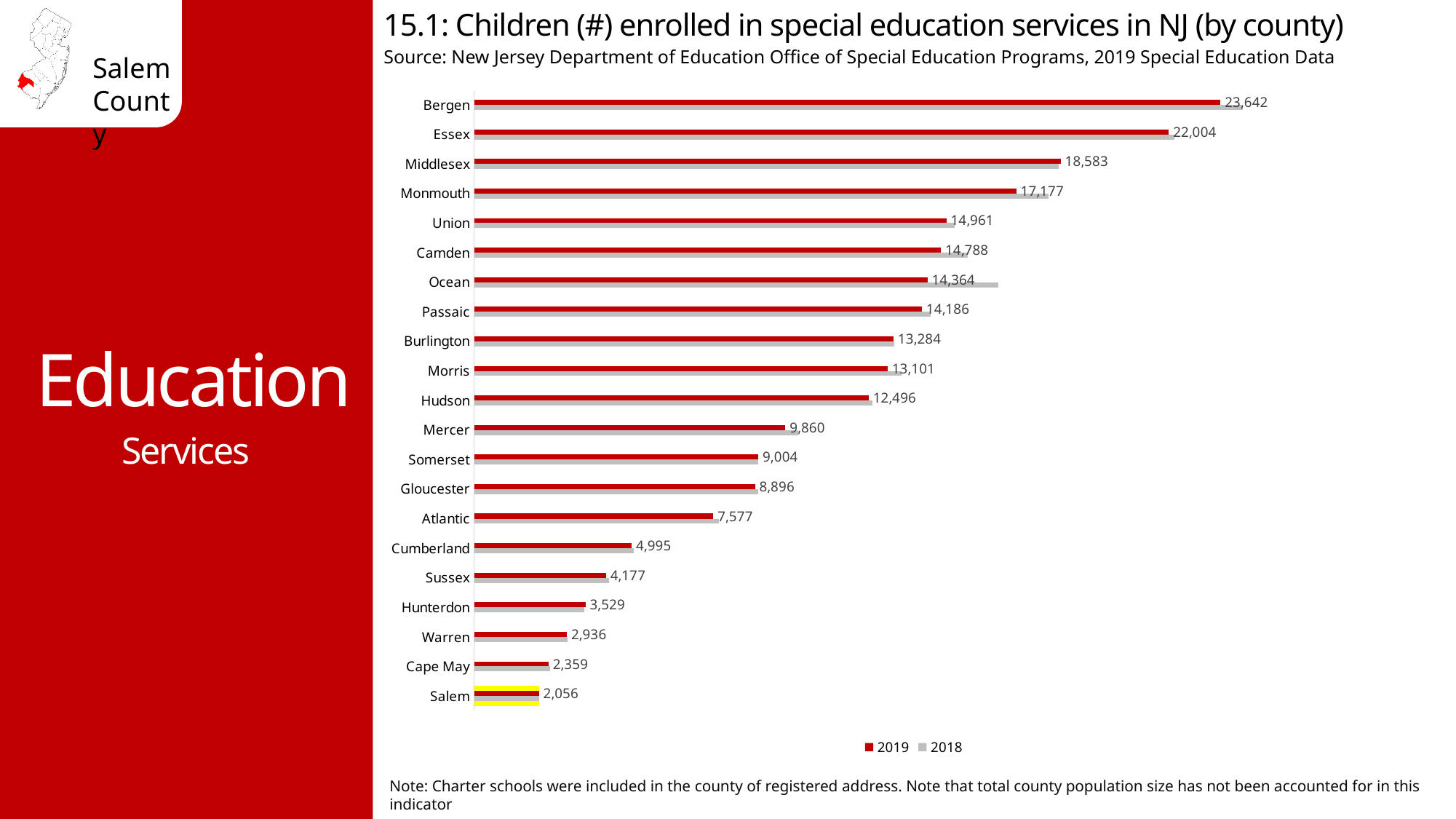
What is the difference between the 2019 values for Cape May and Salem? 303 What type of chart is shown on the slide? bar chart Which series is shown in red in the legend? 2019 What is the 2019 value for Salem? 2,056 Which county has the lowest 2019 value? Salem For Ocean, which series has the larger value, 2019 or 2018? 2018 What is the 2019 value for Bergen? 23,642 What is the 2019 value for Gloucester? 8,896 How many counties are listed on the chart? 21 What is the difference between the 2019 values for Bergen and Essex? 1,638 How many series does the legend list? 2 Which county has the highest 2019 value? Bergen